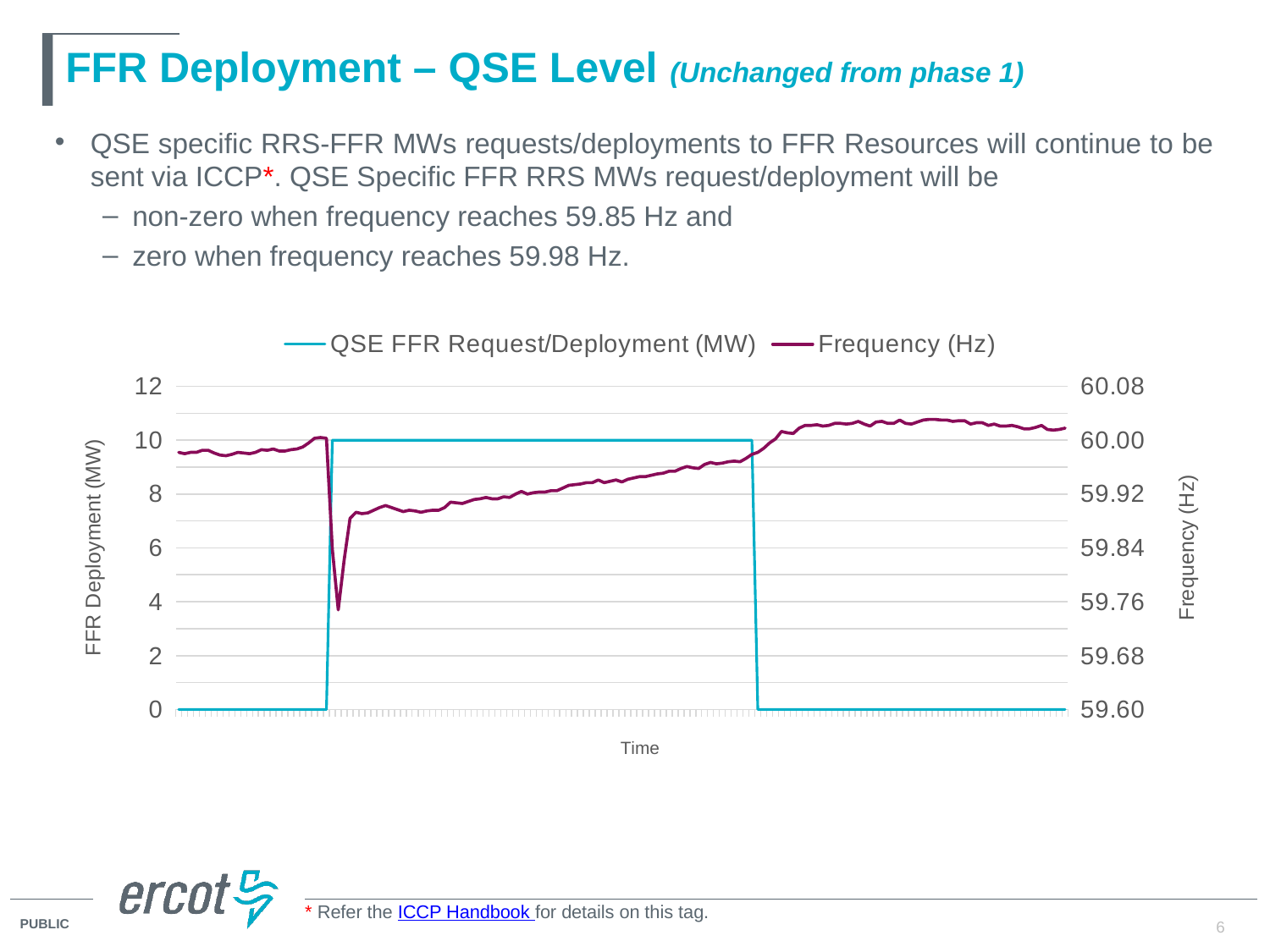
What are the two series named in the chart legend? QSE FFR Request/Deployment (MW) and Frequency (Hz) What kind of chart is shown on the slide? line chart What value does the QSE FFR Request/Deployment (MW) line hold while the deployment is active? 10 After its sharp dip, does the Frequency (Hz) line rise or fall over time? rise What is the highest value reached by the QSE FFR Request/Deployment (MW) line? 10 What value does the QSE FFR Request/Deployment (MW) line hold before the deployment begins? 0 How many series does the chart legend list? 2 Is the lowest value of the Frequency (Hz) line greater or less than 59.84? less Is the Frequency (Hz) value at the start of the chart greater or less than 59.92? greater Is the Frequency (Hz) value at the end of the chart greater or less than 60.00? greater What is the maximum value shown on the right-hand Frequency (Hz) axis? 60.08 What is the title of the chart's x axis? Time